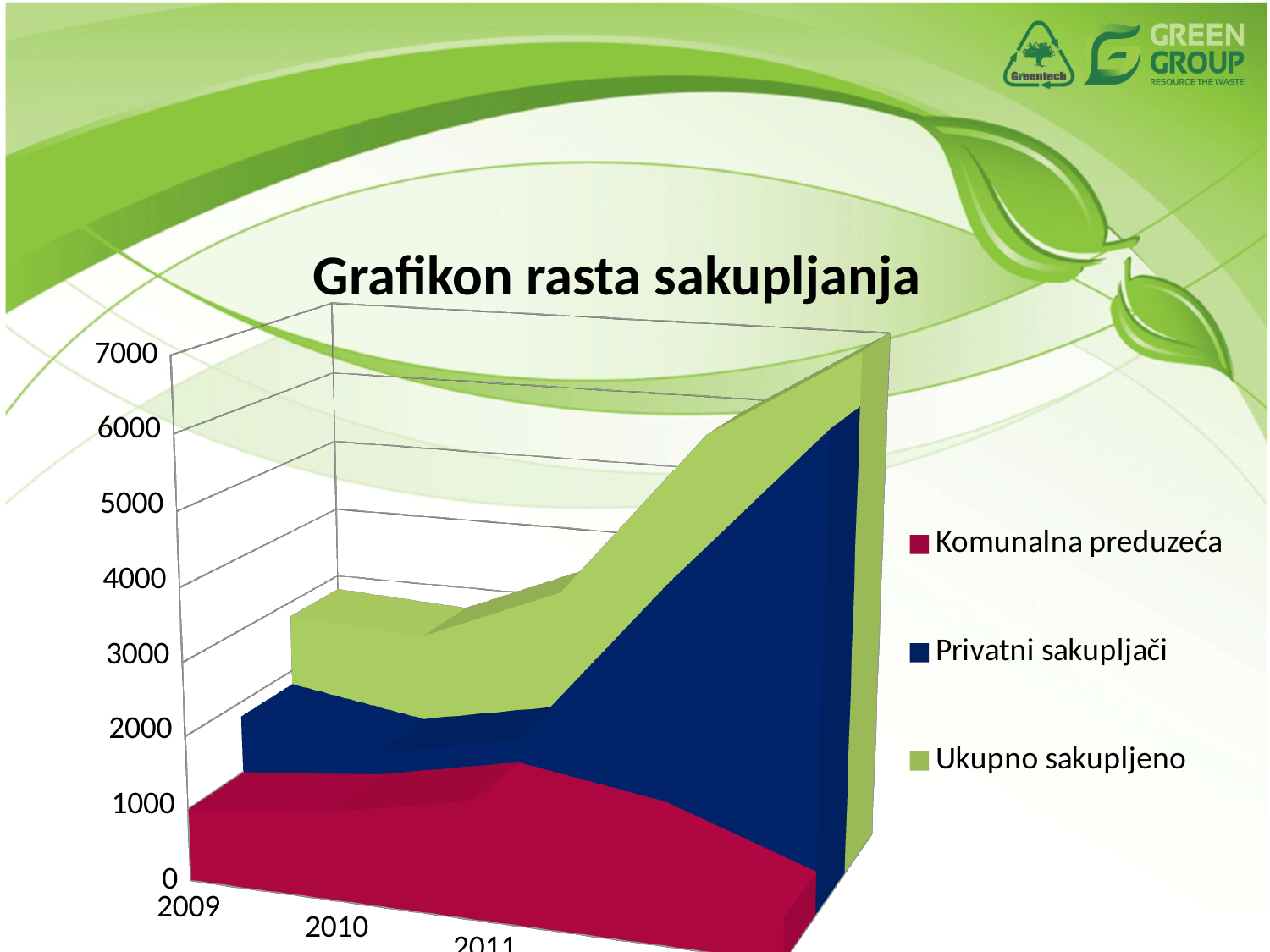
What is the title of the chart? Grafikon rasta sakupljanja Is the value for Ukupno sakupljeno in 2009 greater or less than 2000? greater Does the value for Ukupno sakupljeno rise or fall from 2009 to the last year shown? Rise Which series has the highest values across the chart? Ukupno sakupljeno Which series is shown in green in the legend? Ukupno sakupljeno How many series does the legend list? 3 Is the value for Privatni sakupljači at the last point on the x axis greater or less than 4000? greater At the last point on the x axis, which is larger: Privatni sakupljači or Komunalna preduzeća? Privatni sakupljači Is the value for Komunalna preduzeća in 2009 greater or less than 2000? less What is the highest value shown on the vertical axis? 7000 What kind of chart is shown on the slide? Area chart